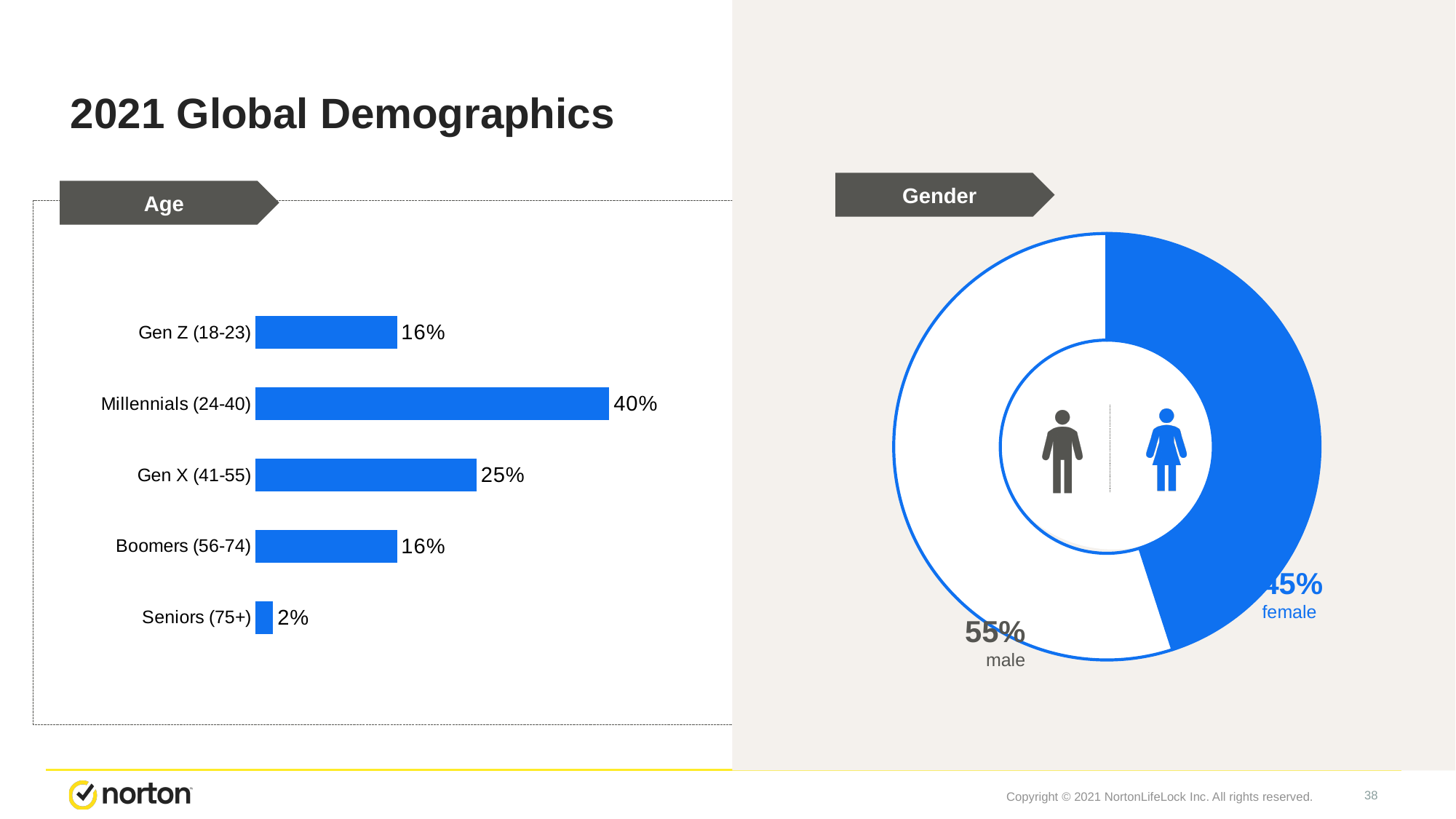
In the Age chart, which age group has the highest percentage? Millennials (24-40) In the Age chart, what is the difference between the Millennials (24-40) and Gen X (41-55) percentages? 15% In the Age chart, which age group has the lowest percentage? Seniors (75+) In the Age chart, what percentage is shown for Millennials (24-40)? 40% In the Age chart, what percentage is shown for Seniors (75+)? 2% In the Gender chart, what percentage is female? 45% How many age groups are shown in the Age chart? 5 In the Gender chart, what percentage is male? 55% In the Age chart, which is larger: Gen X (41-55) or Boomers (56-74)? Gen X (41-55) In the Age chart, what percentage is shown for Gen X (41-55)? 25% What kind of chart is the Age chart? Bar chart In the Gender chart, which share is larger: male or female? Male